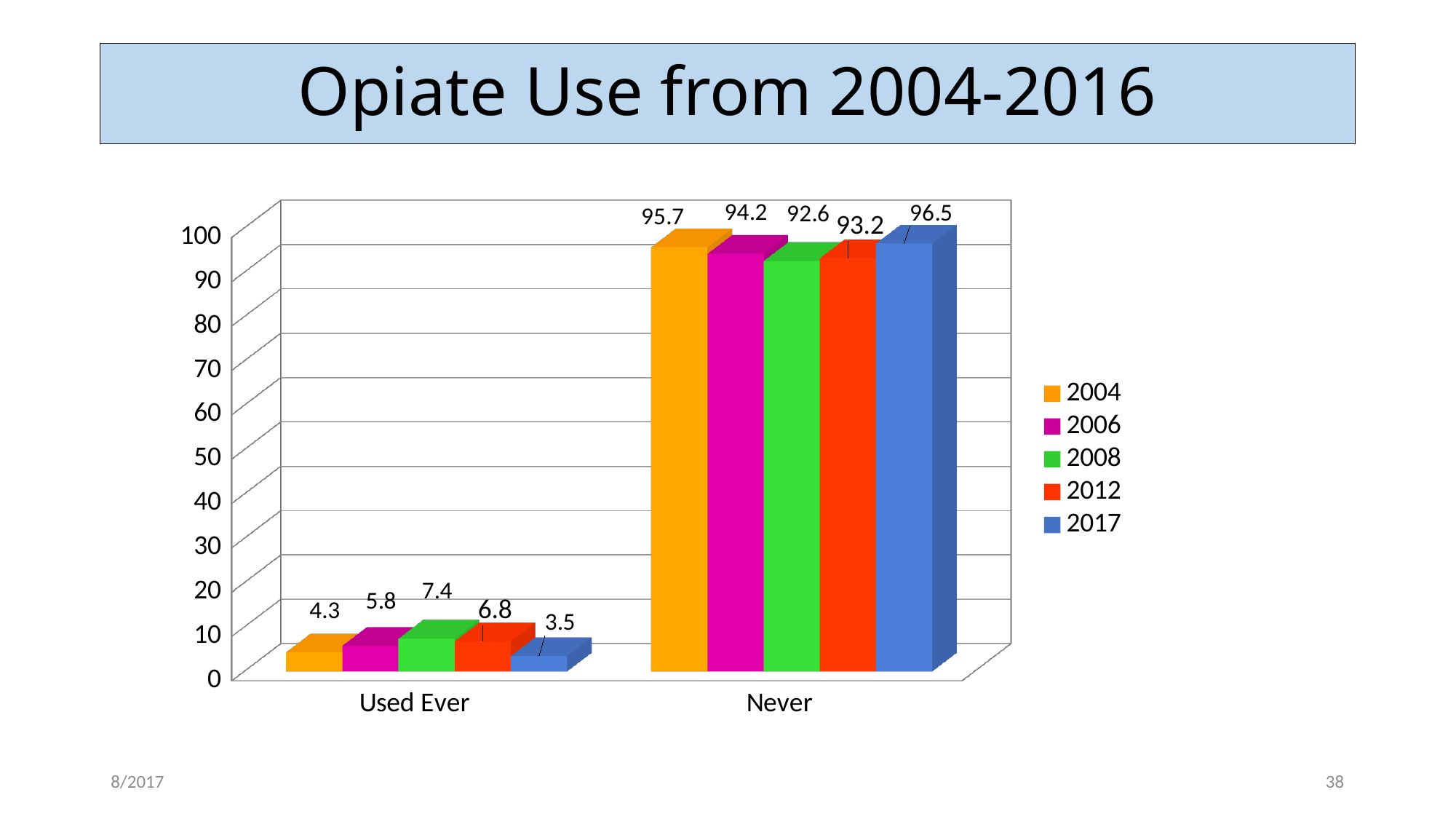
What is the value for 2004 in the Used Ever category? 4.3 Which is larger in the Never category, the value for 2004 or the value for 2006? 2004 Is the value for 2012 in the Never category greater or less than 90? greater What kind of chart is shown on the slide? bar chart What is the difference between the 2008 and 2017 values in the Used Ever category? 3.9 Which year has the lowest value in the Never category? 2008 What is the value for 2017 in the Never category? 96.5 How many series does the legend list? 5 Which year has the highest value in the Used Ever category? 2008 How many categories are shown on the x axis? 2 What is the title of the slide? Opiate Use from 2004-2016 What is the value for 2008 in the Used Ever category? 7.4